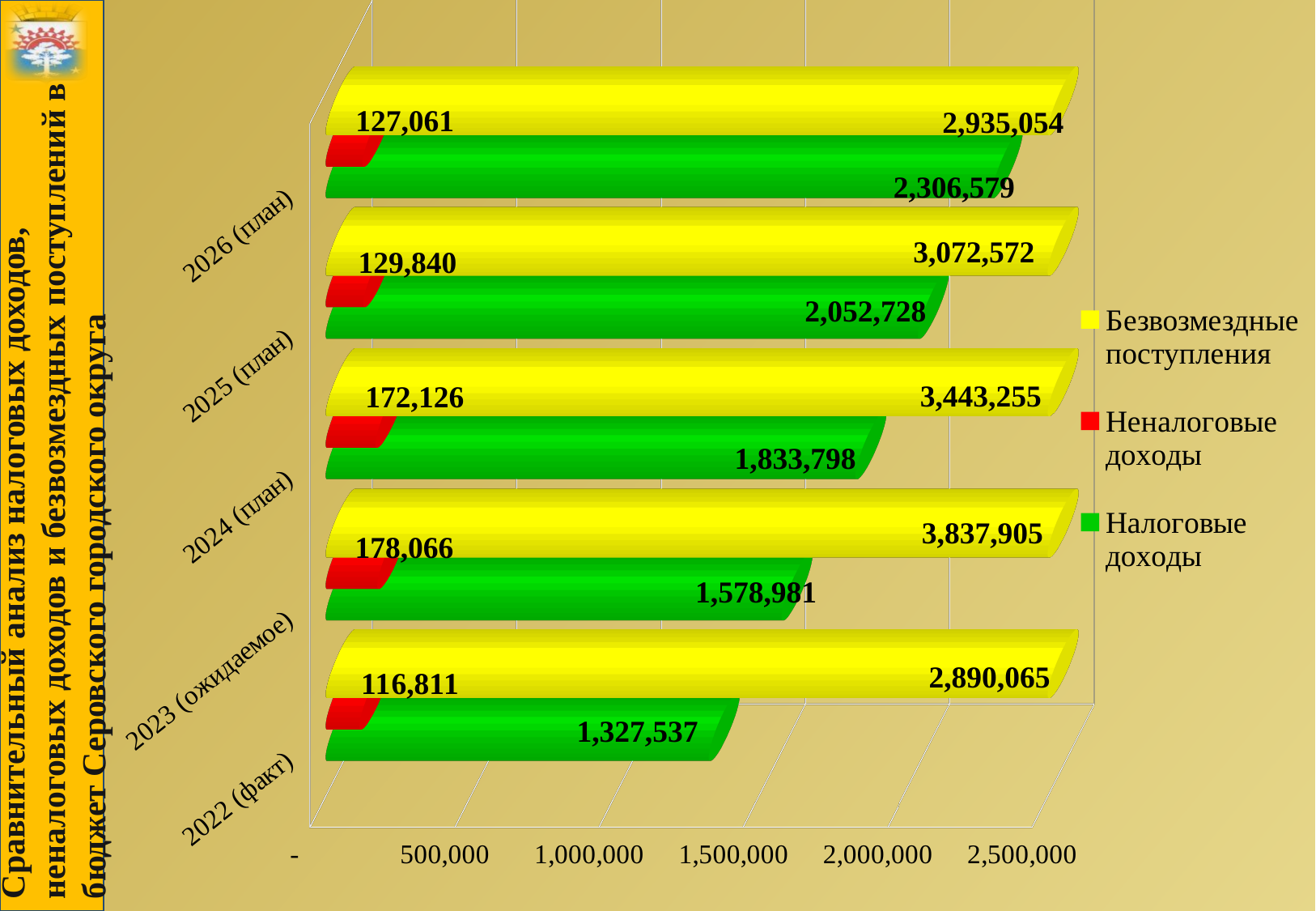
Which year has the lowest value for Неналоговые доходы? 2022 (факт) Which year has the highest value for Налоговые доходы? 2026 (план) Which is larger, Безвозмездные поступления in 2024 (план) or in 2025 (план)? 2024 (план) What is the difference between Неналоговые доходы in 2023 (ожидаемое) and 2024 (план)? 5,940 What is the value of Неналоговые доходы for 2026 (план)? 127,061 What is the difference between Налоговые доходы in 2026 (план) and 2022 (факт)? 979,042 What kind of chart is shown on the slide? bar chart How many years (categories) are shown on the chart? 5 What is the value of Безвозмездные поступления for 2023 (ожидаемое)? 3,837,905 How many series does the legend list? 3 What is the value of Налоговые доходы for 2022 (факт)? 1,327,537 Which year has the highest value for Безвозмездные поступления? 2023 (ожидаемое)